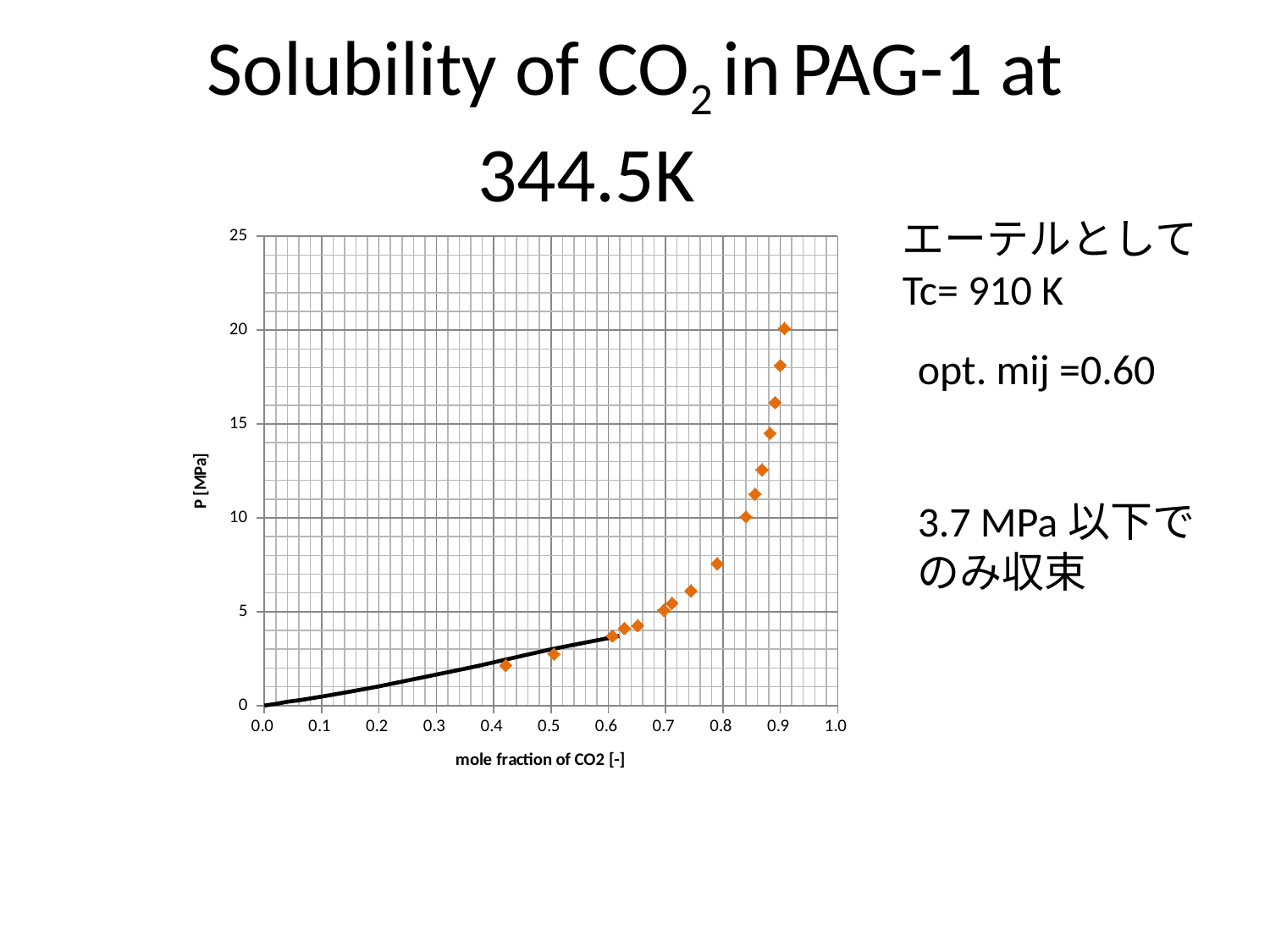
What kind of chart is shown on the slide? scatter chart What is the highest value shown on the y axis of the chart? 25 Is the pressure of the plotted point near mole fraction 0.4 greater or less than 5 MPa? less Is the pressure of the plotted point near mole fraction 0.8 greater or less than 10 MPa? less Is the pressure of the highest plotted point (near mole fraction 0.9) greater or less than 15 MPa? greater What is the label of the y axis of the chart? P [MPa] Which has the higher pressure: the plotted point near mole fraction 0.5 or the plotted point near mole fraction 0.8? the point near 0.8 What is the label of the x axis of the chart? mole fraction of CO2 [-] Does the pressure rise or fall as the mole fraction of CO2 increases along the x axis? rise